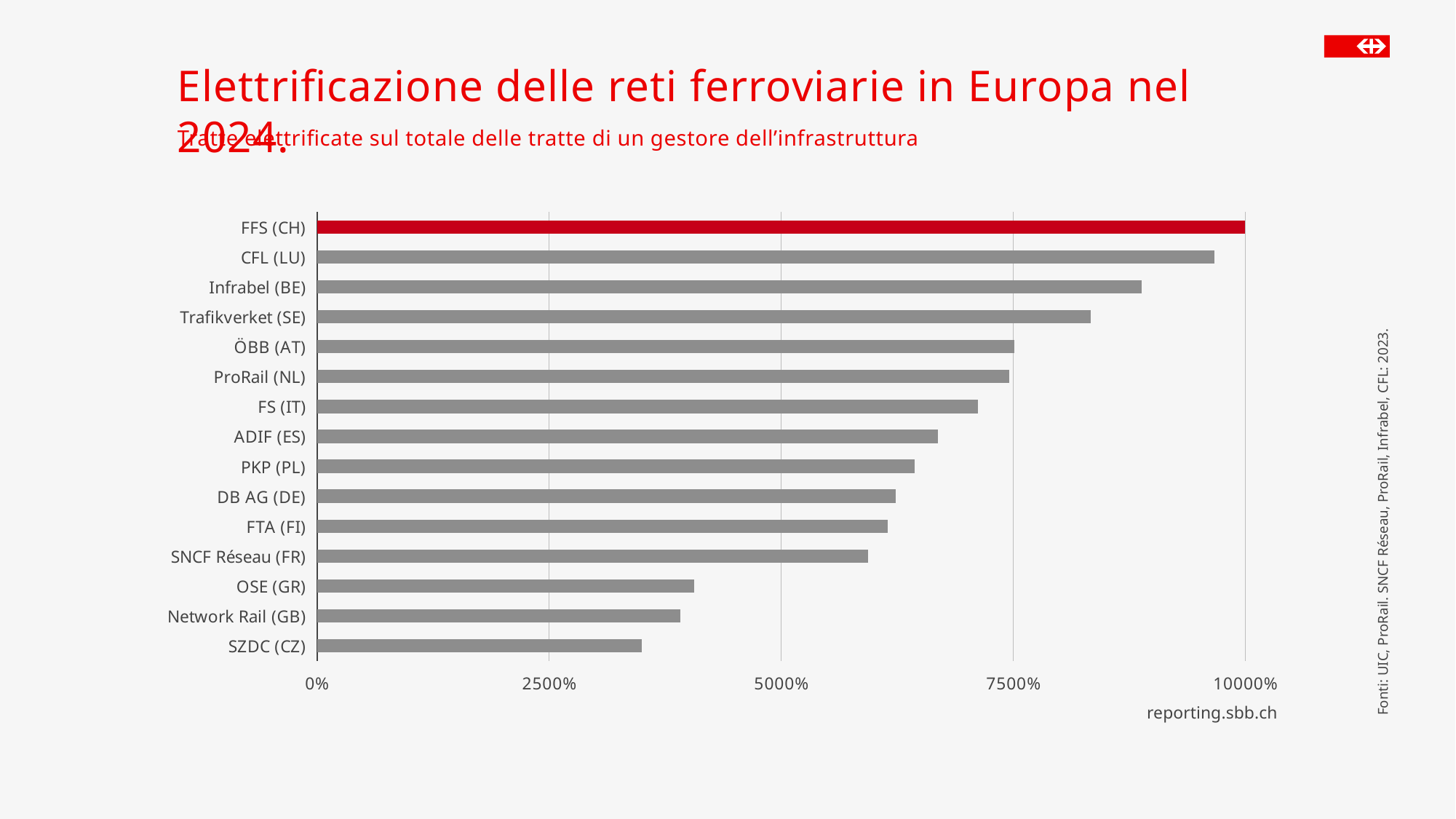
Is the value for OSE (GR) greater or less than 5000%? less Which infrastructure manager has the highest value in the chart? FFS (CH) Is the value for SZDC (CZ) greater or less than 5000%? less What colour is the bar for FFS (CH)? red Is the value for FS (IT) greater or less than 7500%? less How many infrastructure managers (categories) are plotted in the chart? 15 Which has the larger value, Infrabel (BE) or Trafikverket (SE)? Infrabel (BE) Which has the larger value, SNCF Réseau (FR) or OSE (GR)? SNCF Réseau (FR) What kind of chart is shown on the slide? bar chart Which infrastructure manager has the lowest value in the chart? SZDC (CZ)